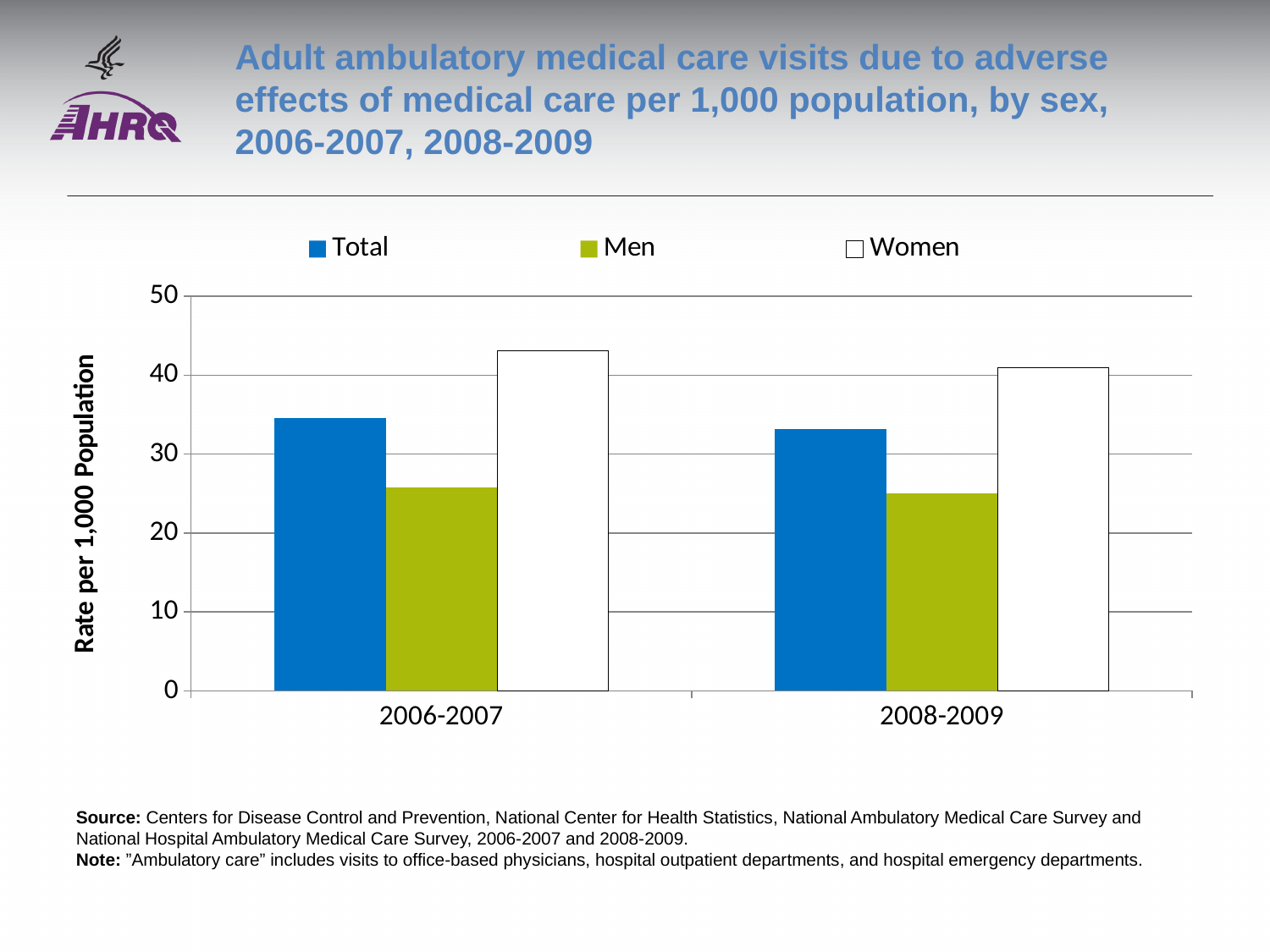
What kind of chart is shown on the slide? bar chart Which is larger, the value for Men in 2006-2007 or the value for Total in 2006-2007? Total in 2006-2007 Is the value for Total in 2006-2007 greater or less than 30? greater Is the value for Women in 2006-2007 greater or less than 40? greater What is the label of the y axis? Rate per 1,000 Population How many time-period categories are shown on the x axis? 2 Which series has the highest value in 2006-2007? Women Is the value for Men in 2008-2009 greater or less than 30? less Which series has the lowest value in 2008-2009? Men How many series does the legend list? 3 Does the value for Women rise or fall from 2006-2007 to 2008-2009? fall